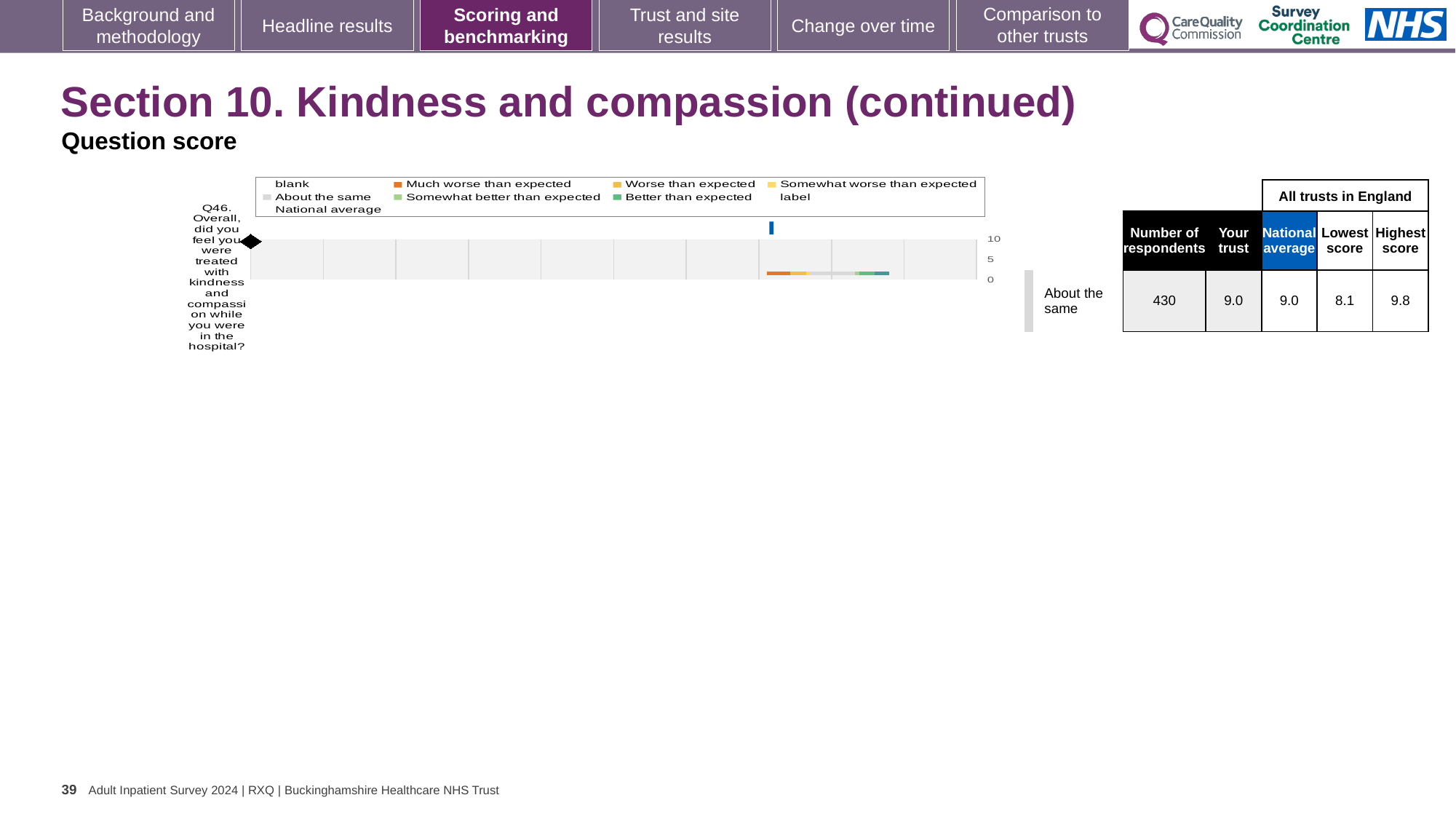
How many respondents answered Q46? 430 What is the highest score among all trusts in England for Q46? 9.8 What is the highest tick value shown on the chart's score axis? 10 What kind of chart is shown on the slide? bar chart What is the 'Your trust' score for Q46 (treated with kindness and compassion)? 9.0 What is the difference between the national average and the lowest score for Q46? 0.9 Which benchmarking category is Q46 assigned to? About the same What is the national average score for Q46? 9.0 Is the 'Your trust' score for Q46 higher than, lower than, or equal to the national average? equal What is the difference between the highest score and the lowest score for Q46? 1.7 What is the lowest score among all trusts in England for Q46? 8.1 How many questions are plotted on the chart? 1